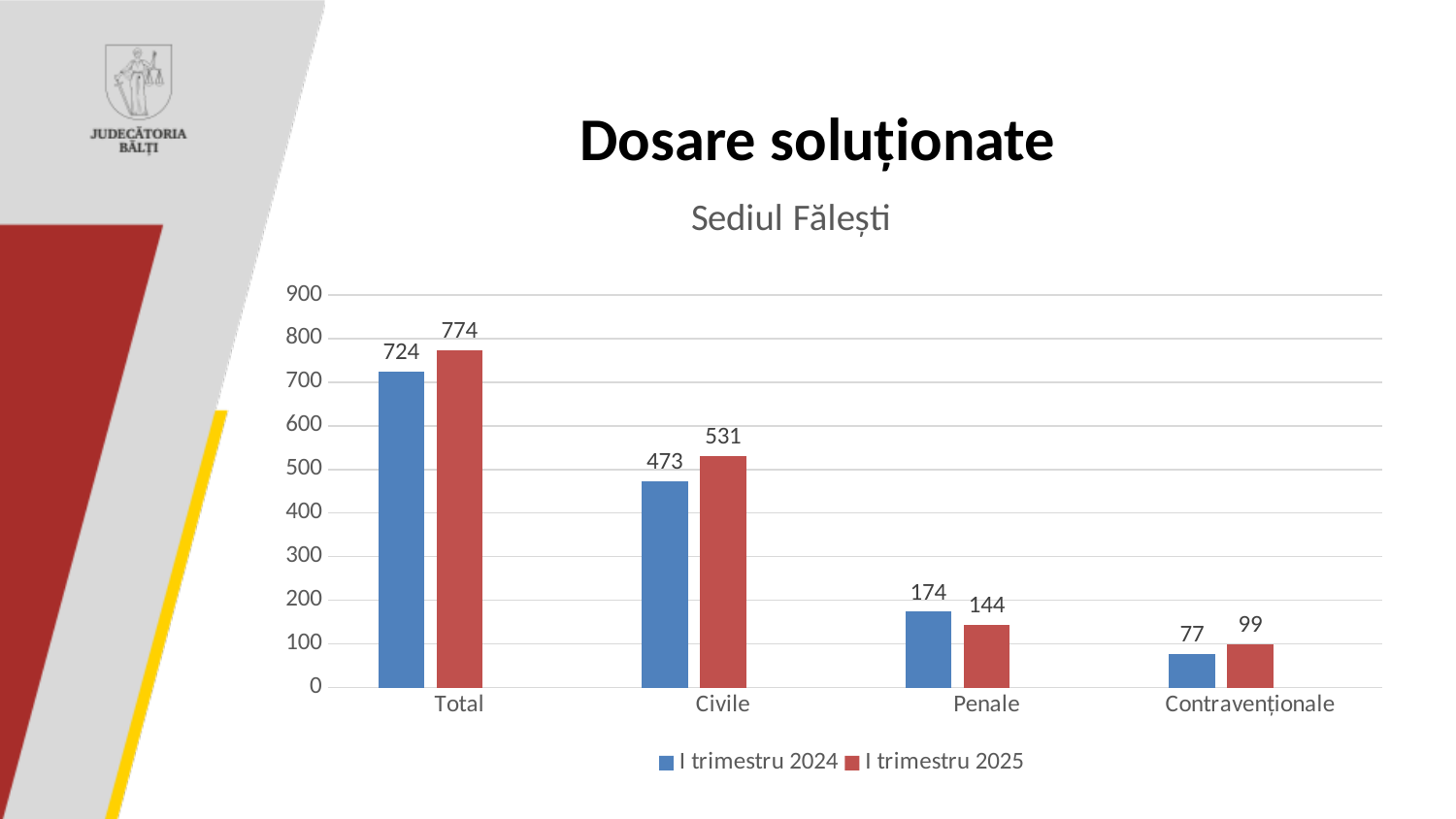
How many series does the legend list? 2 What is the value for Penale in I trimestru 2025? 144 What is the value for Contravenționale in I trimestru 2024? 77 Which category has the lowest value in I trimestru 2025? Contravenționale What is the subtitle shown above the chart? Sediul Fălești What is the difference between the I trimestru 2025 and I trimestru 2024 values for Civile? 58 What is the value for Civile in I trimestru 2024? 473 How many categories are shown on the x axis? 4 Which is larger for Penale: I trimestru 2024 or I trimestru 2025? I trimestru 2024 What kind of chart is shown on the slide? Bar chart Which category has the highest value in I trimestru 2024? Total What is the value for Total in I trimestru 2025? 774